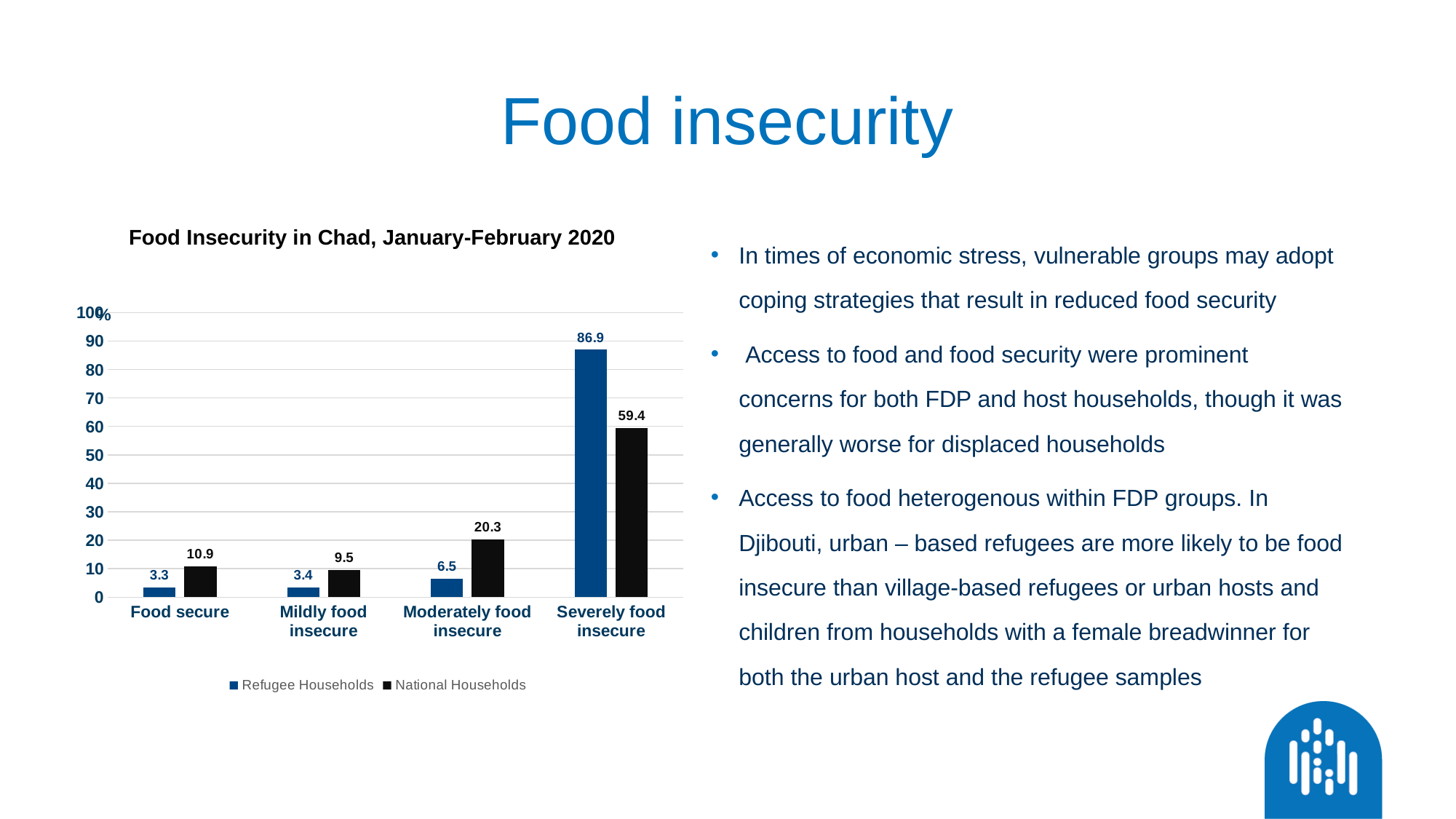
What type of chart is shown on the slide? Bar chart What is the value for Refugee Households in the Food secure category? 3.3 Which category has the lowest value for Refugee Households? Food secure What is the value for National Households in the Moderately food insecure category? 20.3 What is the difference between Refugee Households and National Households in the Severely food insecure category? 27.5 How many categories are shown on the x axis? 4 What is the value for Refugee Households in the Severely food insecure category? 86.9 Which category has the highest value for National Households? Severely food insecure What is the value for National Households in the Mildly food insecure category? 9.5 In the Moderately food insecure category, which is larger: Refugee Households or National Households? National Households How many series does the legend list? 2 Is the value for Refugee Households in the Severely food insecure category greater or less than 80? greater